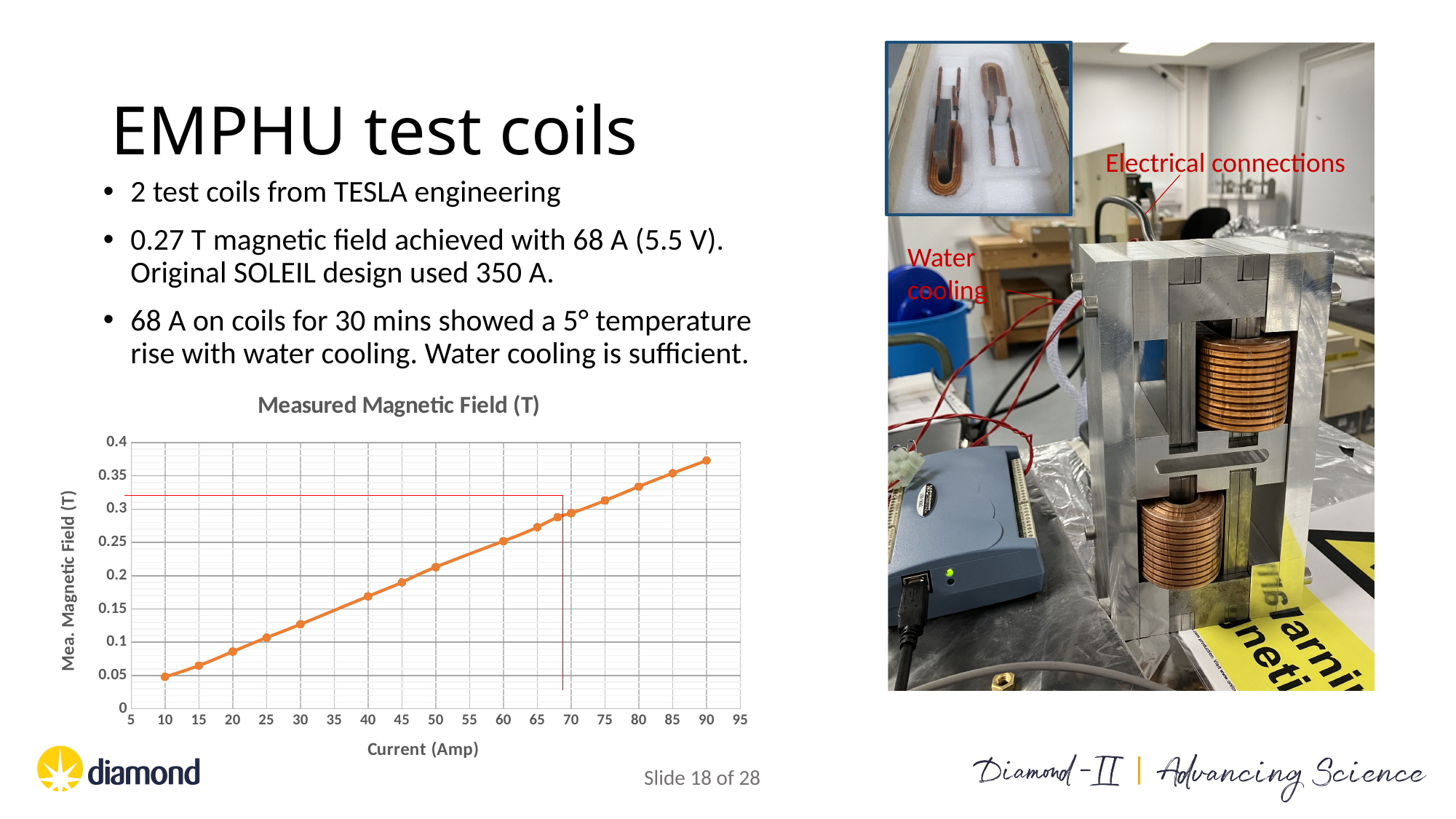
What is the title of the chart? Measured Magnetic Field (T) What is the label of the x axis of the chart? Current (Amp) Which has the larger measured magnetic field, 45 A or 75 A? 75 A Is the measured magnetic field at 30 A greater or less than 0.15? less Is the measured magnetic field at 20 A greater or less than 0.1? less Is the measured magnetic field at 80 A greater or less than 0.35? less At which current is the measured magnetic field highest? 90 What kind of chart is shown on the slide? line chart Does the measured magnetic field rise or fall as the current increases along the x axis? rises At which current is the measured magnetic field lowest? 10